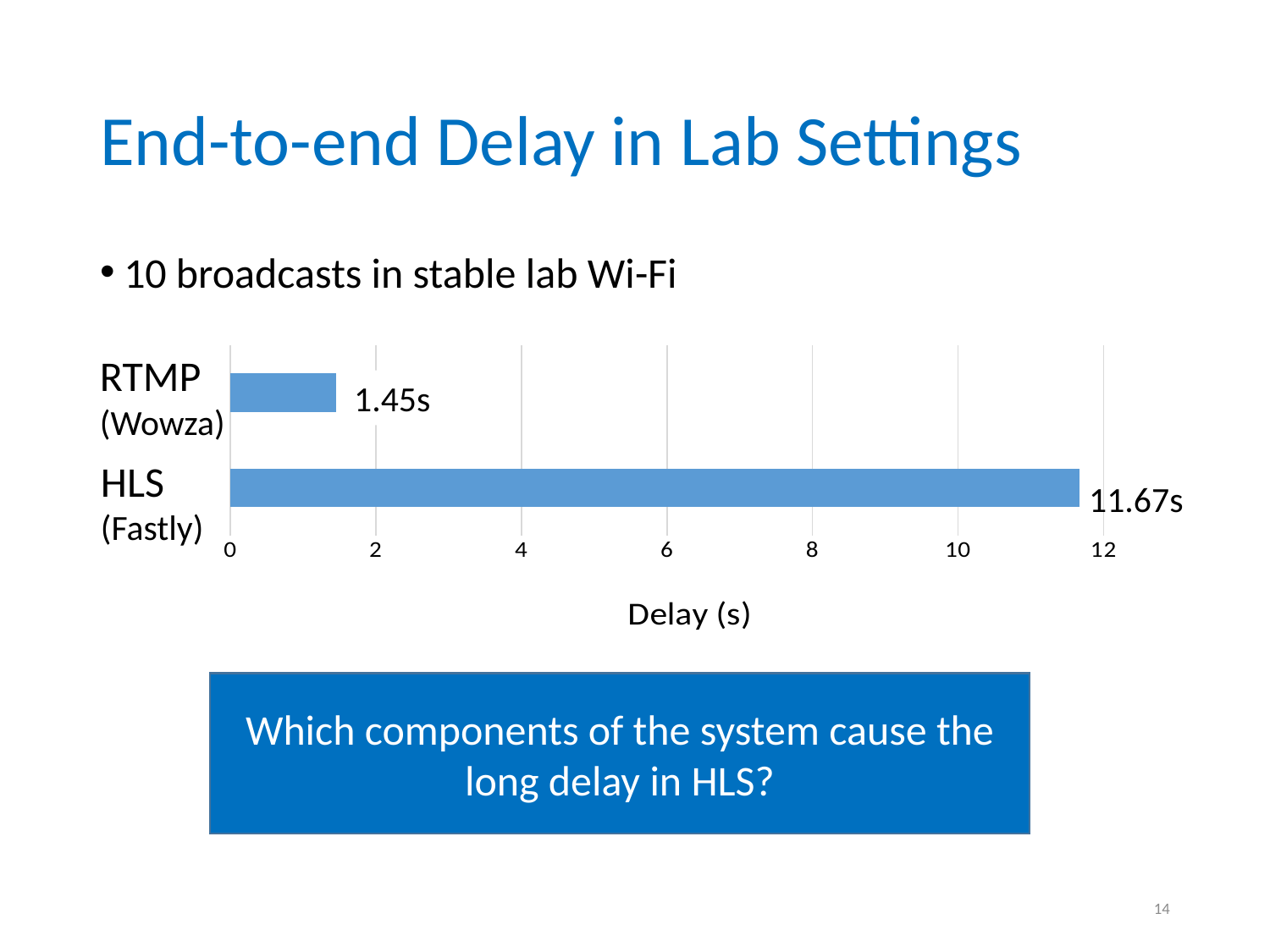
What is the delay for RTMP (Wowza)? 1.45s What is the difference in delay between HLS (Fastly) and RTMP (Wowza)? 10.22s Which category has the lowest delay? RTMP (Wowza) What kind of chart is shown on the slide? Bar chart Is the delay for HLS (Fastly) greater or less than 10? greater What is the maximum value shown on the x axis? 12 How many categories are shown in the chart? 2 What is the label of the x axis? Delay (s) What is the delay for HLS (Fastly)? 11.67s Is the delay for RTMP (Wowza) greater or less than 2? less Which category has the highest delay? HLS (Fastly) Which has a larger delay, RTMP (Wowza) or HLS (Fastly)? HLS (Fastly)